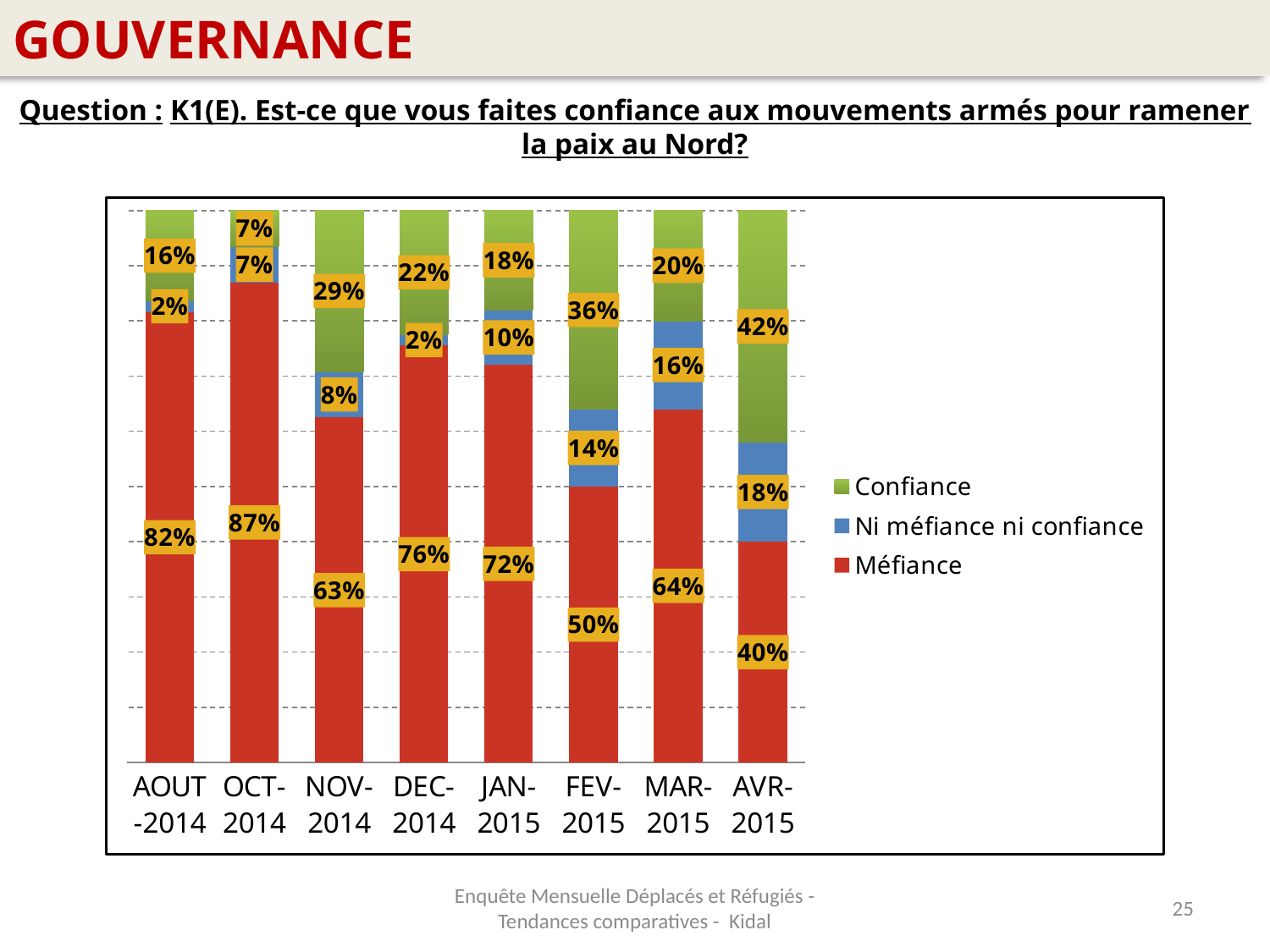
Does the Méfiance value rise or fall from JAN-2015 to AVR-2015? fall In which month is the Méfiance value the lowest? AVR-2015 What is the difference between the Méfiance values for OCT-2014 and AVR-2015? 47% How many months (categories) are shown on the x axis? 8 Which colour represents the Méfiance series in the chart? red How many series does the legend list? 3 What type of chart is shown on the slide? stacked bar chart In which month is the Confiance value the highest? AVR-2015 What is the Méfiance value for OCT-2014? 87% Which is larger: the Confiance value for NOV-2014 or for DEC-2014? NOV-2014 What is the 'Ni méfiance ni confiance' value for FEV-2015? 14% What is the Confiance value for AVR-2015? 42%